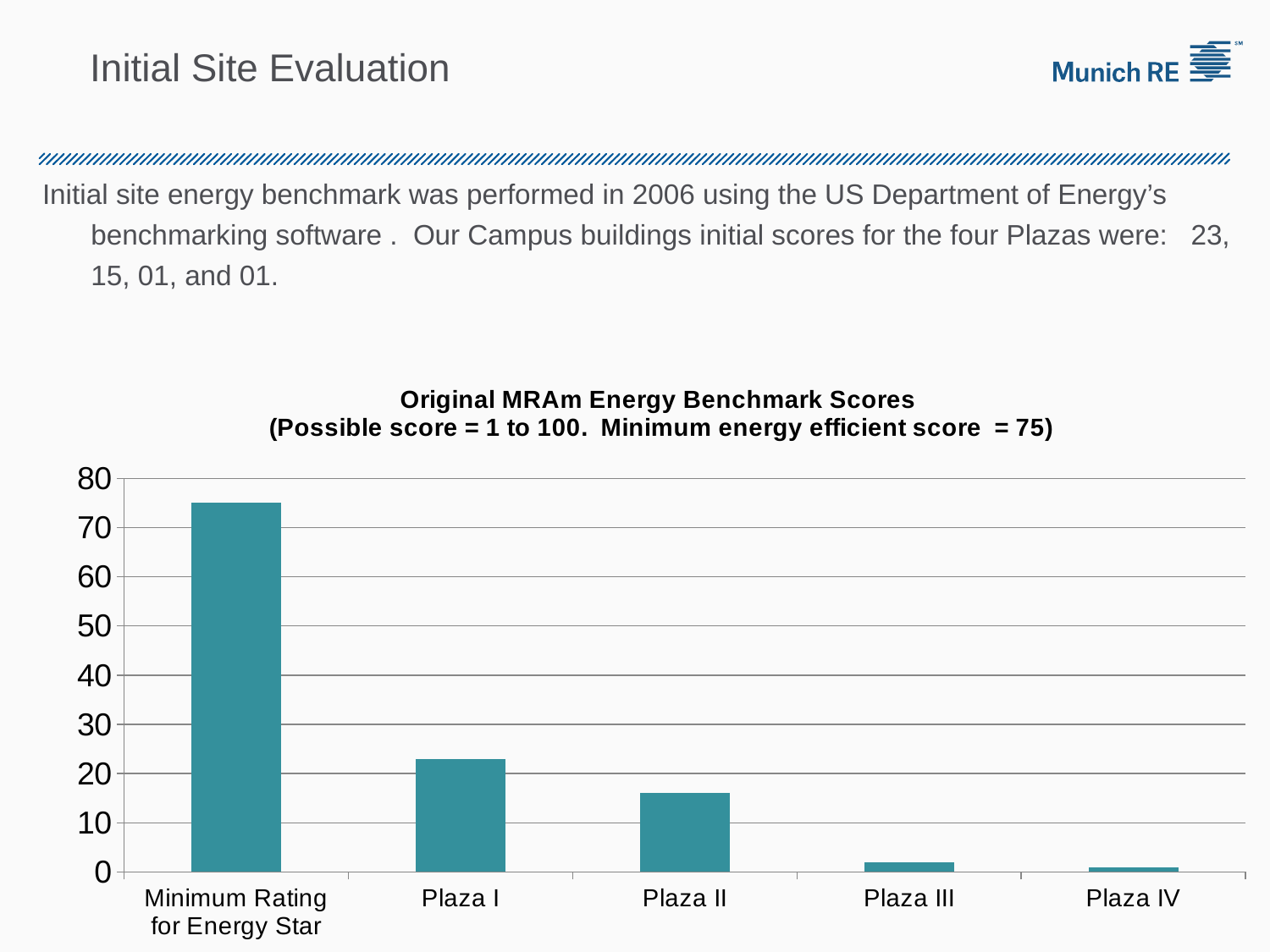
Is the value for Plaza I greater or less than 20? greater Do the bar values rise or fall moving from left to right across the x axis? Fall Is the value for Plaza II greater or less than 10? greater Is the value for Plaza II greater or less than 20? less What is the title of the chart? Original MRAm Energy Benchmark Scores (Possible score = 1 to 100. Minimum energy efficient score = 75) Which category has the highest bar in the chart? Minimum Rating for Energy Star What type of chart is shown on the slide? Bar chart Which has the larger value, Plaza I or Plaza II? Plaza I How many categories are shown on the x axis of the chart? 5